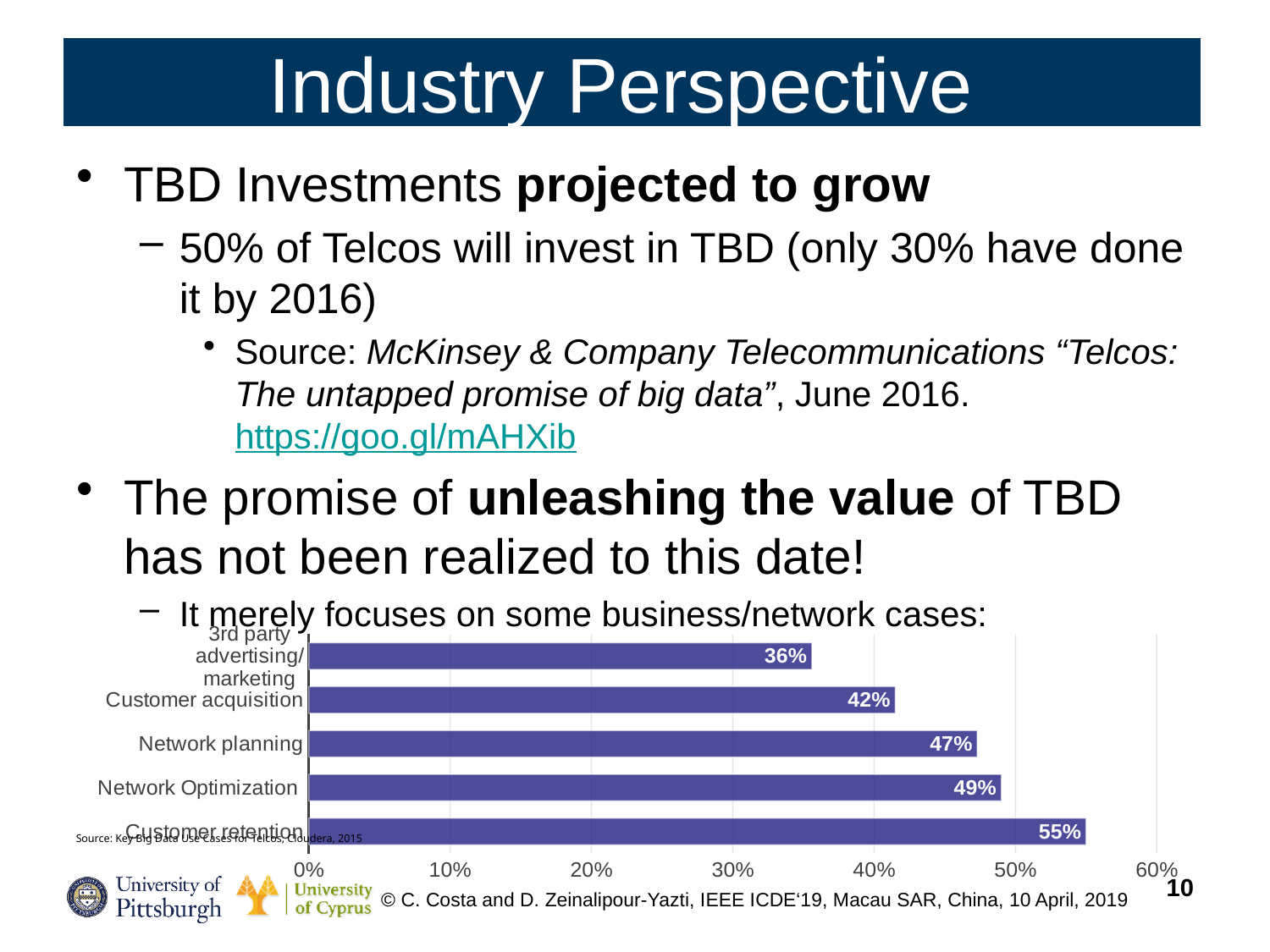
Is the value for Network Optimization greater or less than 40%? greater What is the difference between the values for Customer retention and Network Optimization? 6% What is the value for Network planning? 47% What is the value for Customer retention? 55% What kind of chart is shown on the slide? bar chart Which category has the lowest value? 3rd party advertising/marketing What is the maximum value shown on the horizontal axis of the chart? 60% What is the value for Customer acquisition? 42% Which category has the highest value? Customer retention Which is larger, the value for Network planning or the value for Customer acquisition? Network planning What is the value for 3rd party advertising/marketing? 36% How many categories are shown in the chart? 5